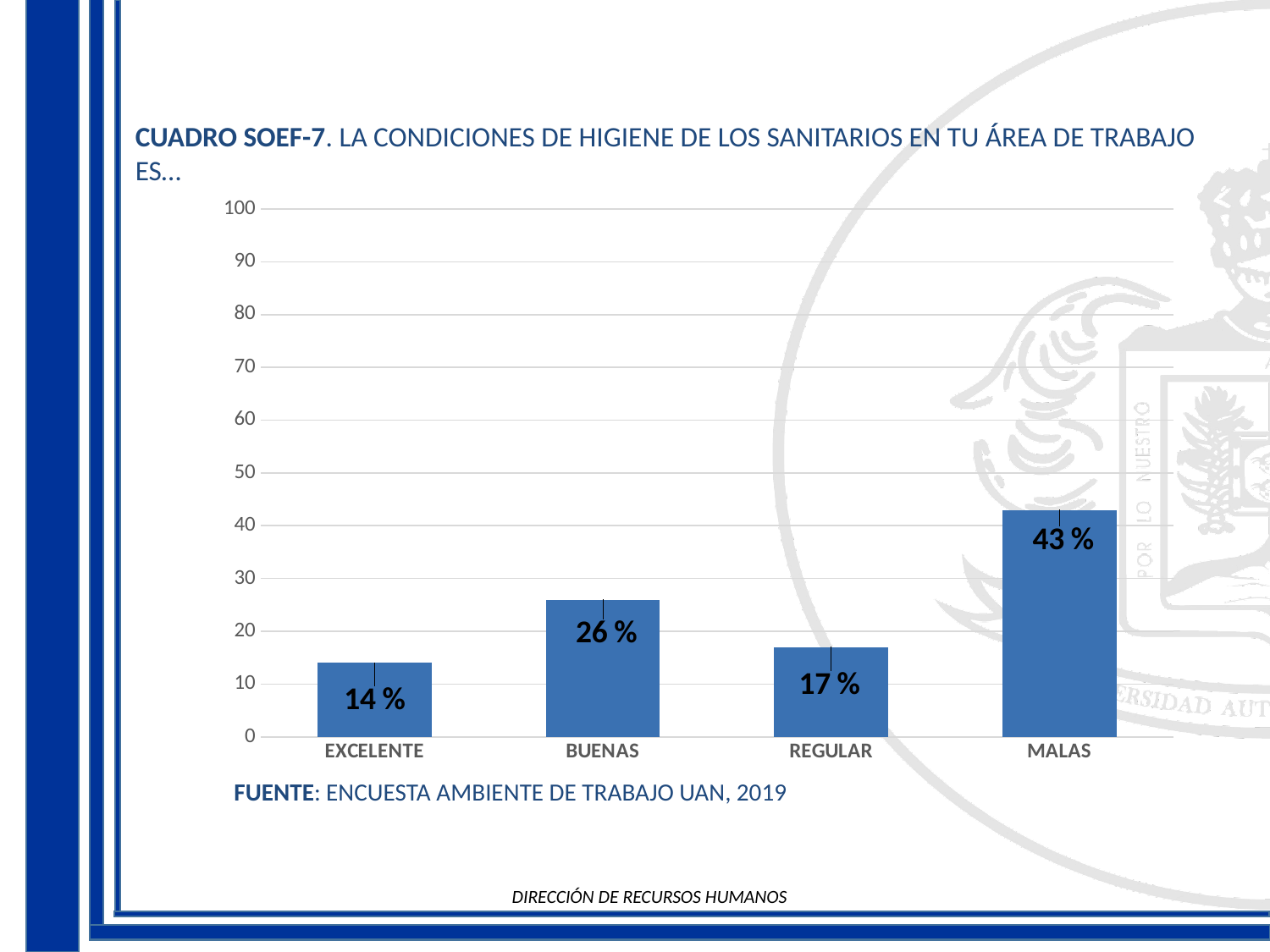
What kind of chart is shown on the slide? bar chart What is the difference between the values for MALAS and BUENAS? 17 % What is the value for MALAS? 43 % What is the value for REGULAR? 17 % What source is cited below the chart? ENCUESTA AMBIENTE DE TRABAJO UAN, 2019 Is the value for MALAS greater or less than 40? greater Which category has the highest value? MALAS Which category has the lowest value? EXCELENTE What is the value for BUENAS? 26 % What is the value for EXCELENTE? 14 % Which is larger, the value for BUENAS or the value for REGULAR? BUENAS How many categories are shown on the x axis? 4